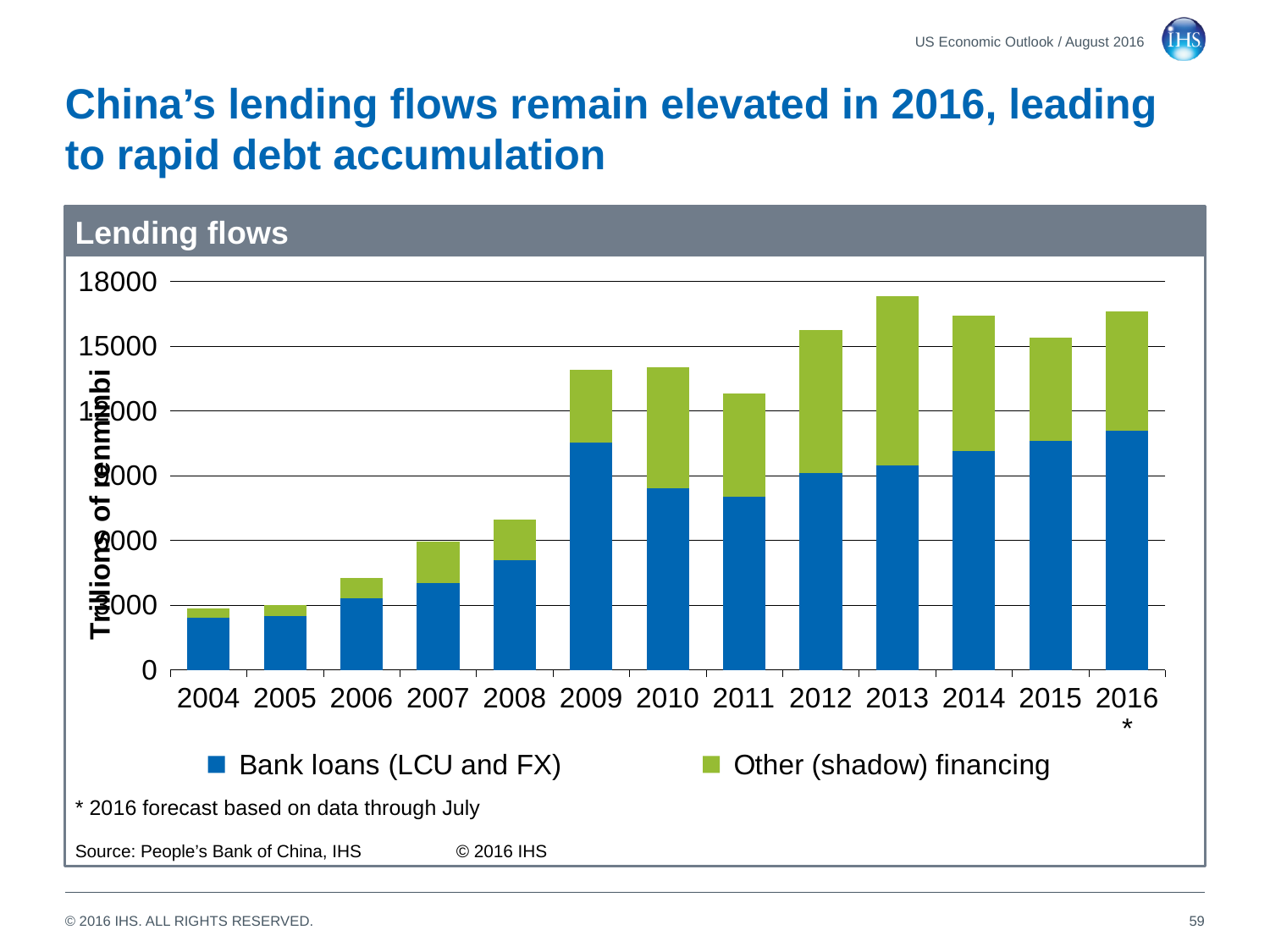
What is the title of the chart on the slide? Lending flows Is the total lending flow for 2008 greater or less than 6000? greater Do total lending flows rise or fall from 2004 to 2009? rise How many series does the legend of the Lending flows chart list? 2 Which year has the lowest total lending flows? 2004 Which year has the larger total lending flow, 2008 or 2009? 2009 What kind of chart is shown on the slide? Stacked bar chart How many years are shown on the x axis of the Lending flows chart? 13 Which year has the highest total lending flows? 2013 Is the Bank loans (LCU and FX) value for 2009 greater or less than 9000? greater Is the total lending flow for 2011 greater or less than 15000? less